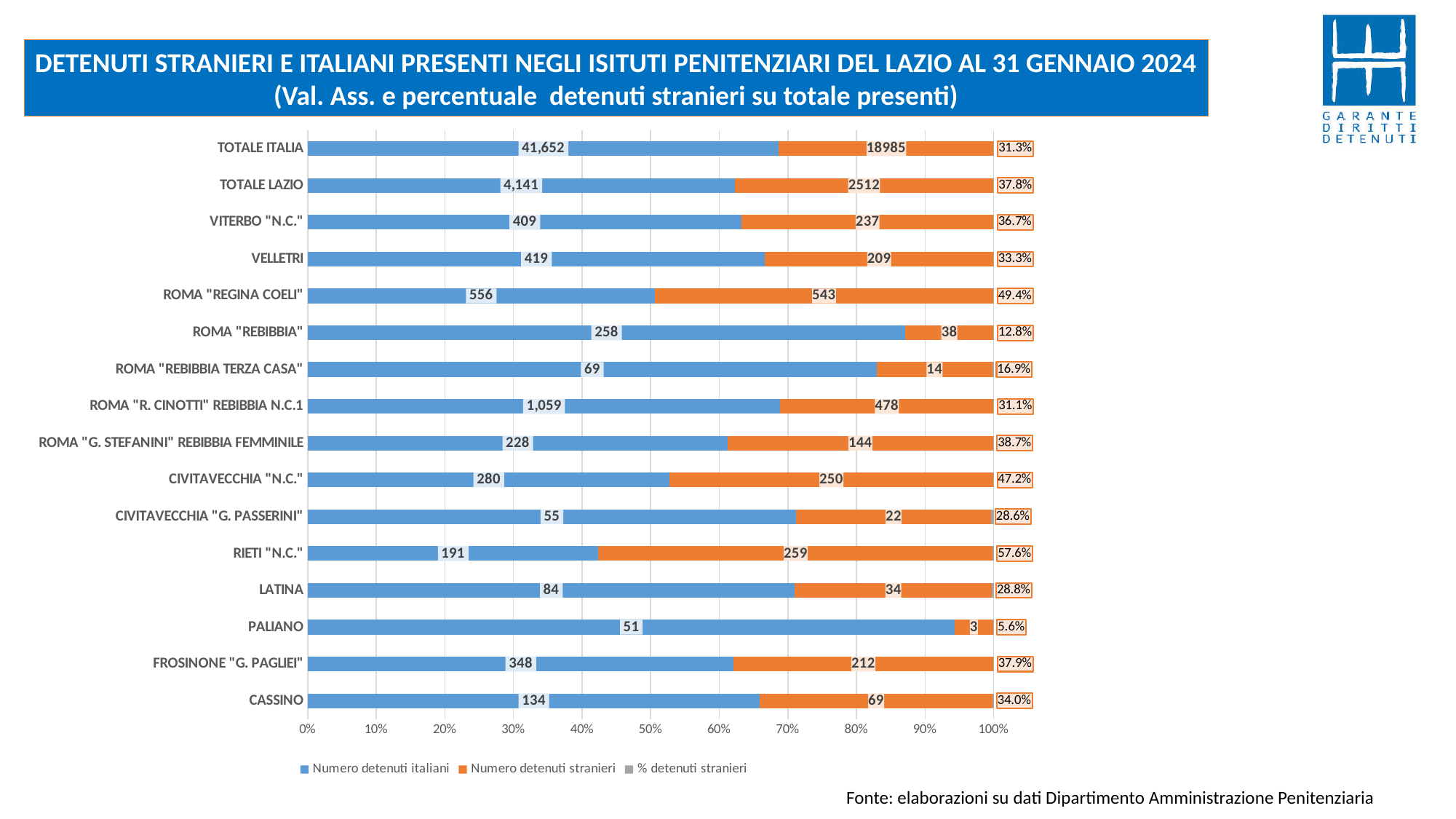
Which institution has the lowest percentage of foreign detainees? PALIANO What is the number of Italian detainees (Numero detenuti italiani) for TOTALE LAZIO? 4,141 What kind of chart is shown on the slide? Bar chart What percentage of foreign detainees is shown for VITERBO "N.C."? 36.7% What is the difference between the number of Italian detainees and foreign detainees at ROMA "REGINA COELI"? 13 At CIVITAVECCHIA "N.C.", which is larger: the number of Italian detainees or the number of foreign detainees? Numero detenuti italiani How many categories (rows) are shown on the chart? 16 How many series does the legend list? 3 What is the number of foreign detainees (Numero detenuti stranieri) for ROMA "REGINA COELI"? 543 What colour represents Numero detenuti stranieri in the chart? Orange Which institution has the highest percentage of foreign detainees? RIETI "N.C." What is the total number of detainees (Italian plus foreign) at CASSINO? 203